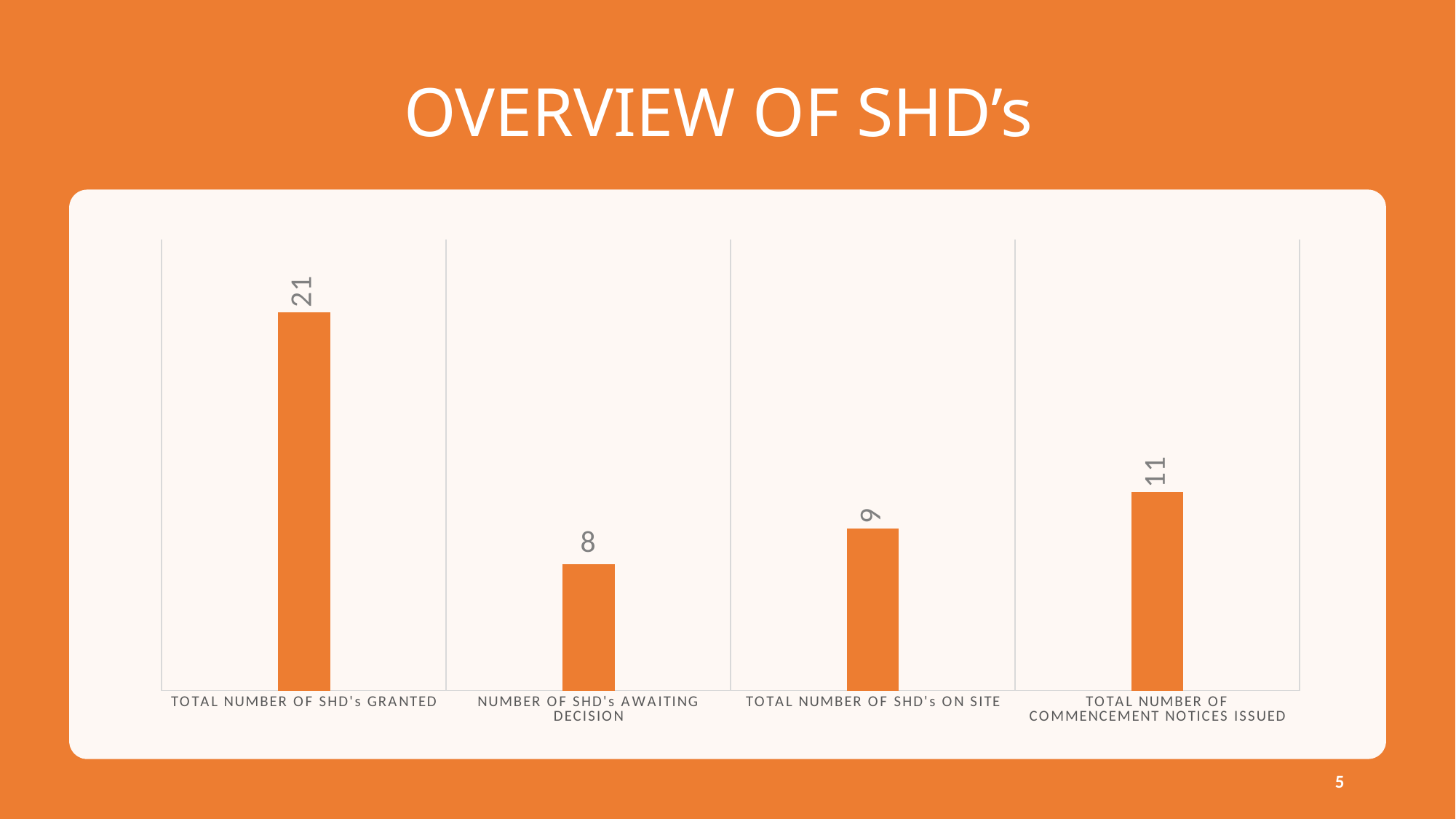
Which is larger: the total number of commencement notices issued or the total number of SHD's on site? Total number of commencement notices issued What is the total number of SHD's on site? 9 What is the difference between the total number of SHD's on site and the number of SHD's awaiting decision? 1 What is the total number of commencement notices issued? 11 Which category has the highest value? Total number of SHD's granted How many categories are shown in the chart? 4 What is the difference between the total number of SHD's granted and the total number of commencement notices issued? 10 Which category has the lowest value? Number of SHD's awaiting decision What is the total number of SHD's granted? 21 What is the number of SHD's awaiting decision? 8 What kind of chart is shown on the slide? Bar chart What is the title of the slide? OVERVIEW OF SHD's